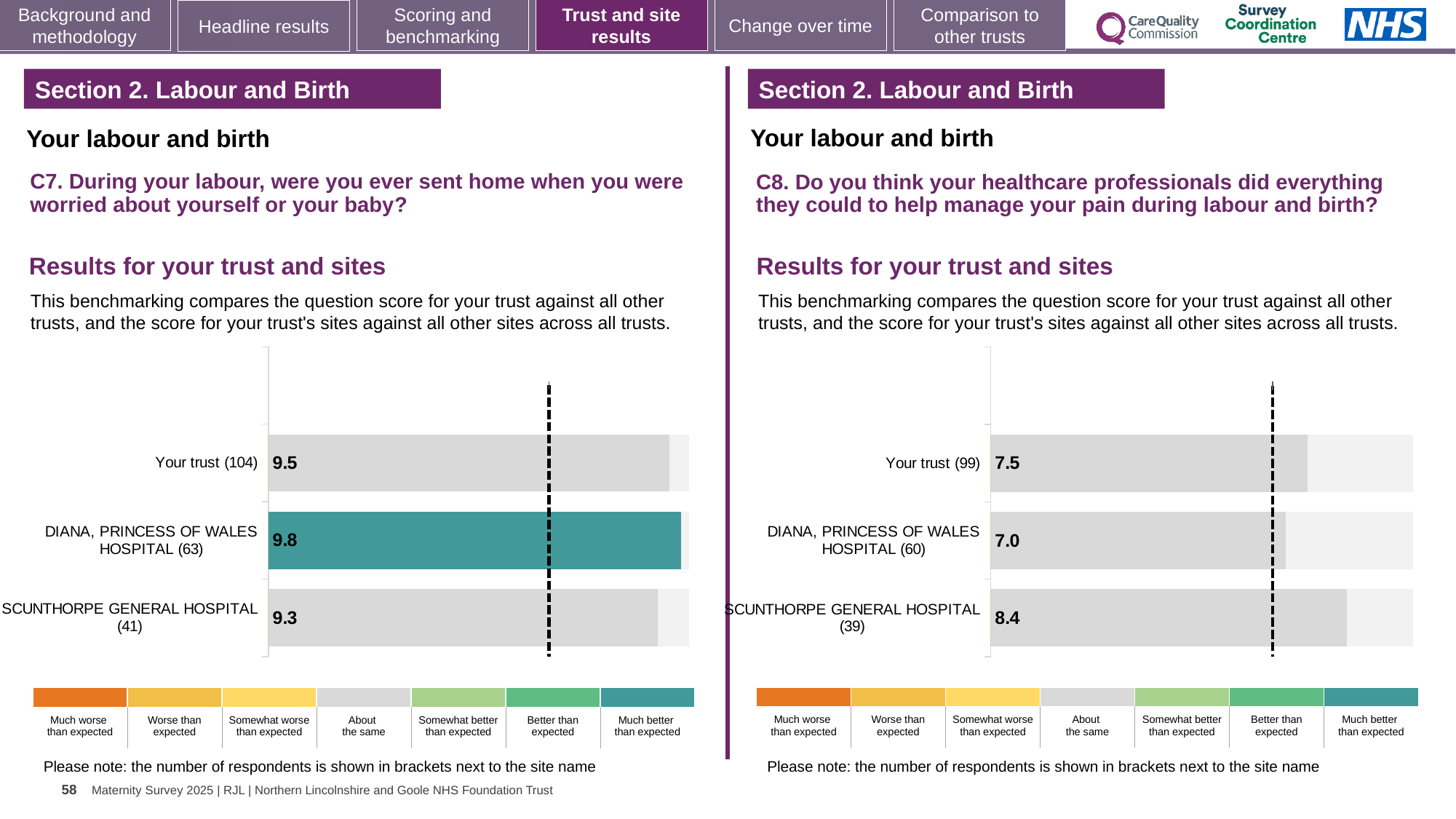
On the C7 chart (left), which site or trust has the highest score? DIANA, PRINCESS OF WALES HOSPITAL On the C8 chart (right), what is the score for SCUNTHORPE GENERAL HOSPITAL? 8.4 What kind of chart is used on the C8 chart (right)? bar chart On the C7 chart (left), what is the score for DIANA, PRINCESS OF WALES HOSPITAL? 9.8 On the C7 chart (left), what is the score for Your trust? 9.5 On the C8 chart (right), what is the difference between the scores for SCUNTHORPE GENERAL HOSPITAL and DIANA, PRINCESS OF WALES HOSPITAL? 1.4 On the C7 chart (left), what is the difference between the scores for DIANA, PRINCESS OF WALES HOSPITAL and SCUNTHORPE GENERAL HOSPITAL? 0.5 On the C7 chart (left), what is the score for SCUNTHORPE GENERAL HOSPITAL? 9.3 On the C8 chart (right), is the score for SCUNTHORPE GENERAL HOSPITAL larger or smaller than the score for Your trust? larger How many bars are plotted on the C7 chart (left)? 3 On the C8 chart (right), what is the score for Your trust? 7.5 On the C8 chart (right), which site or trust has the lowest score? DIANA, PRINCESS OF WALES HOSPITAL